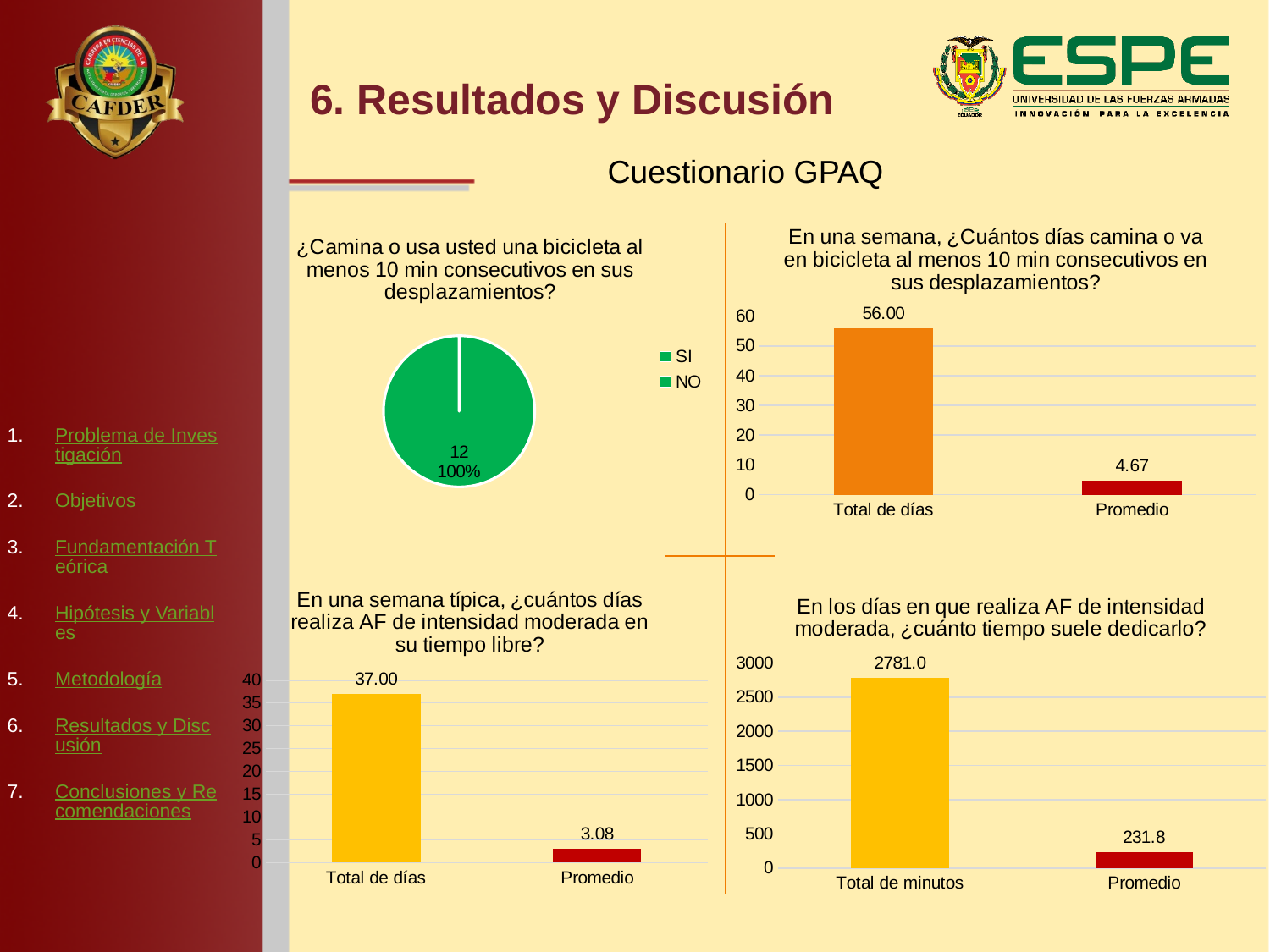
In the bottom-right chart (En los días en que realiza AF de intensidad moderada, ¿cuánto tiempo suele dedicarlo?), what is the value for Promedio? 231.8 In the bottom-left chart (En una semana típica...), which category has the higher value, Total de días or Promedio? Total de días In the top-right chart (En una semana, ¿Cuántos días camina o va en bicicleta...), what is the value for Total de días? 56.00 In the top-right chart (En una semana, ¿Cuántos días camina...), what is the difference between Total de días and Promedio? 51.33 How many entries does the legend of the top-left pie chart list? 2 In the bottom-right chart (En los días en que realiza AF de intensidad moderada, ¿cuánto tiempo suele dedicarlo?), what is the value for Total de minutos? 2781.0 What kind of chart is the top-left chart (¿Camina o usa usted una bicicleta...)? Pie chart In the top-left pie chart (¿Camina o usa usted una bicicleta...), what percentage is shown for the single slice? 100% What kind of chart is the bottom-right chart (En los días en que realiza AF de intensidad moderada...)? Bar chart In the bottom-left chart (En una semana típica, ¿cuántos días realiza AF de intensidad moderada...), what is the value for Promedio? 3.08 In the top-right chart (En una semana, ¿Cuántos días camina o va en bicicleta...), what is the value for Promedio? 4.67 In the bottom-left chart (En una semana típica, ¿cuántos días realiza AF de intensidad moderada...), what is the value for Total de días? 37.00